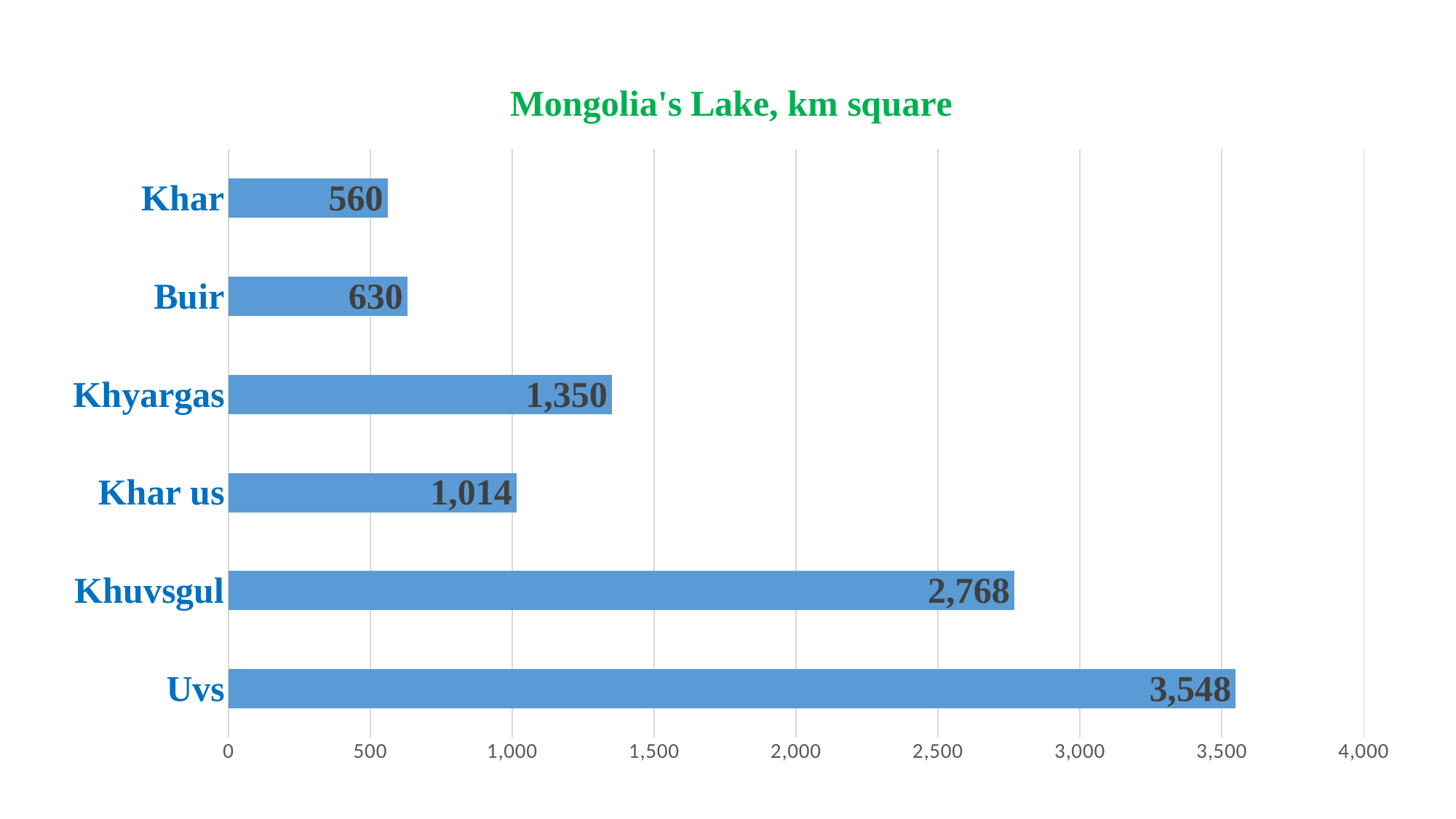
What is the difference between the values for Uvs and Khuvsgul? 780 What is the value shown for Khyargas? 1,350 What is the value shown for Khuvsgul? 2,768 Is the value for Khuvsgul greater or less than 2,500? greater What is the difference between the values for Buir and Khar? 70 Which lake has the largest area? Uvs What is the value shown for Khar us? 1,014 How many lakes are shown in the chart? 6 What type of chart is shown on the slide? Bar chart What is the area of Uvs lake in km square? 3,548 Which is larger, the value for Khyargas or the value for Khar us? Khyargas Which lake has the smallest area? Khar